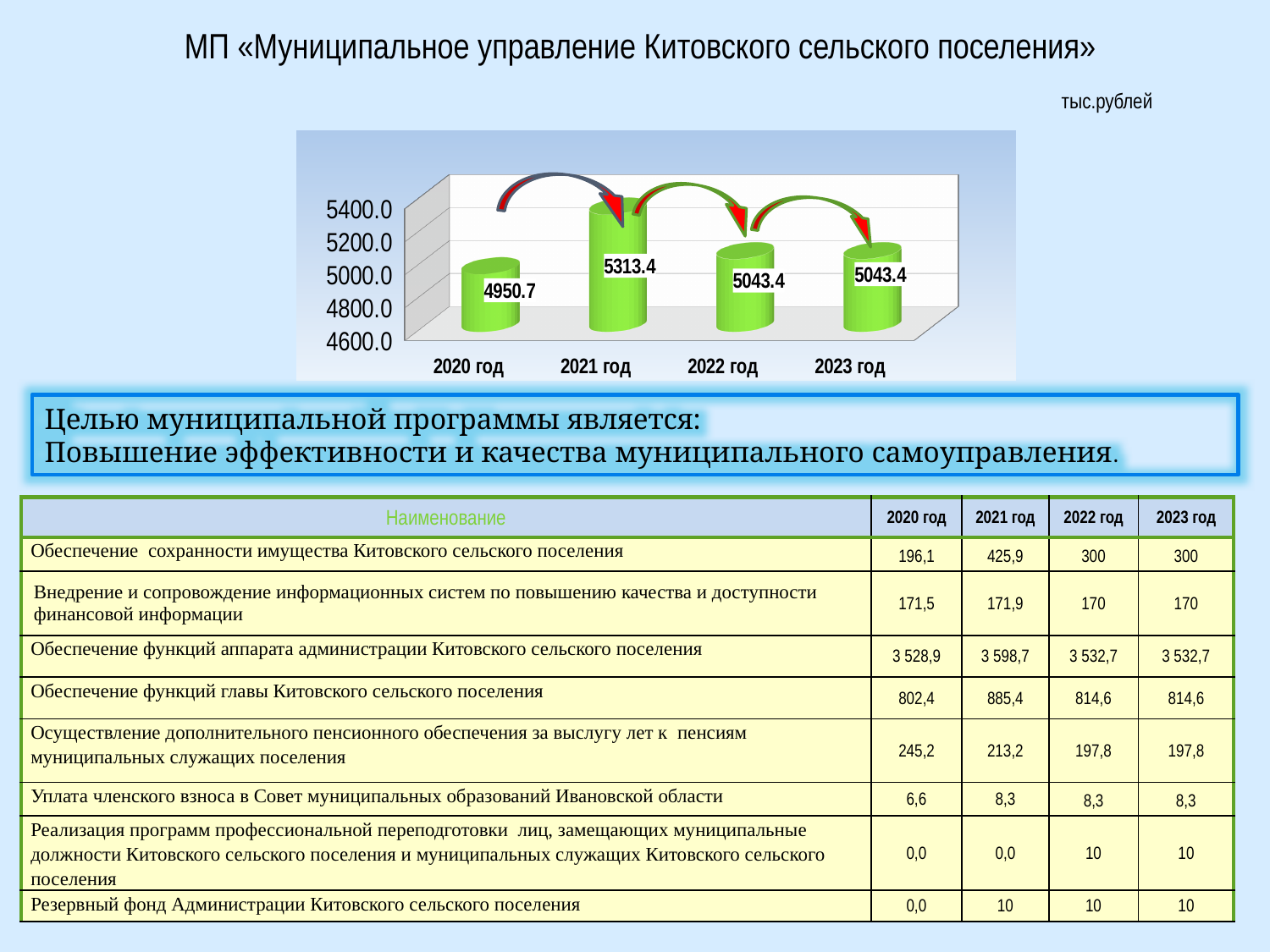
Is the value for 2021 год greater or less than 5200.0? greater What is the value shown for 2023 год on the chart? 5043.4 Which year has the lowest value on the chart? 2020 год Which year has the highest value on the chart? 2021 год Which is larger, the value for 2020 год or the value for 2022 год? 2022 год How many years are shown on the chart? 4 What is the value shown for 2020 год on the chart? 4950.7 What is the difference between the values for 2021 год and 2020 год? 362.7 What kind of chart is shown on the slide? bar chart What is the value shown for 2022 год on the chart? 5043.4 What is the value shown for 2021 год on the chart? 5313.4 What is the difference between the values for 2021 год and 2022 год? 270.0